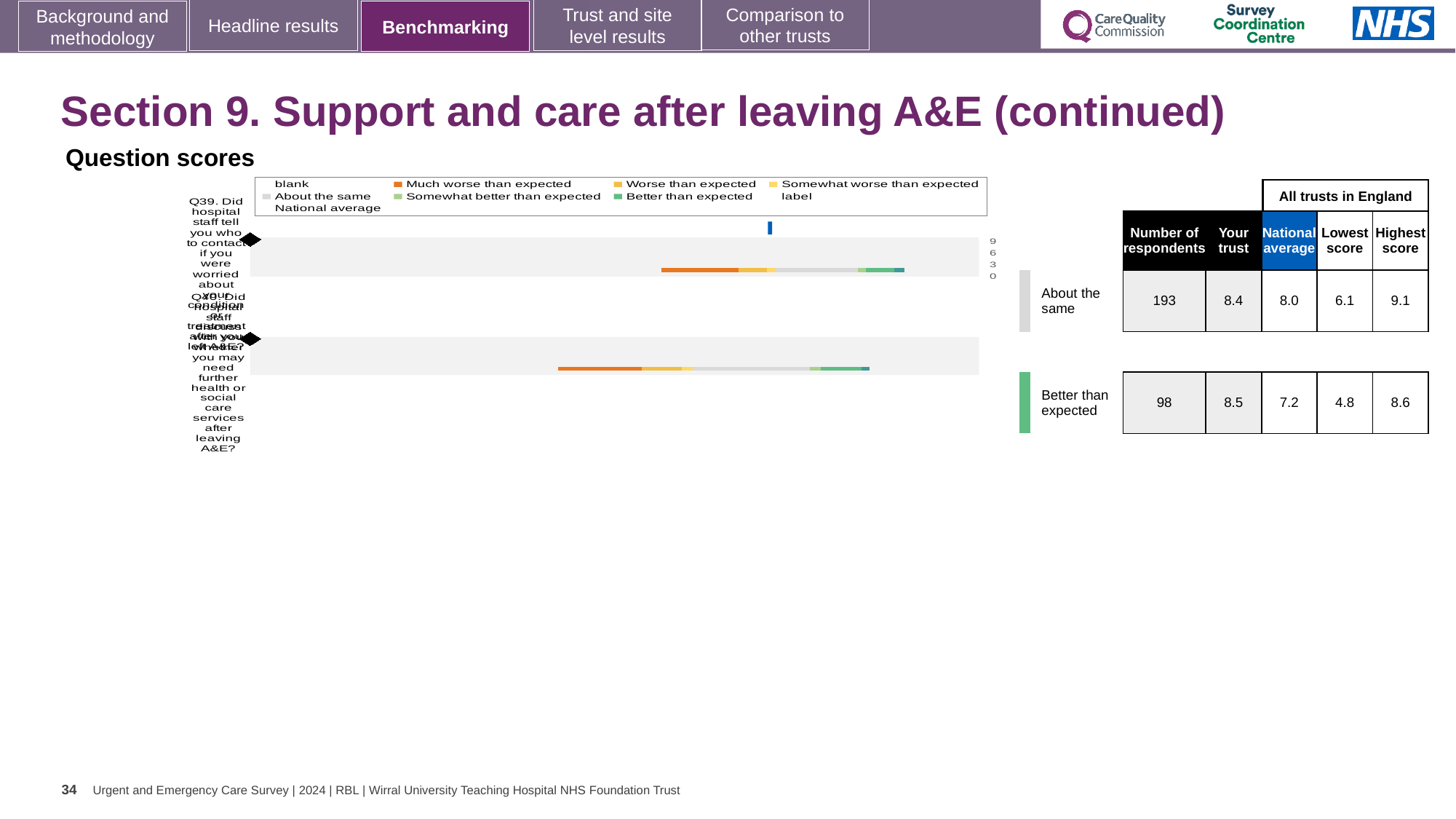
What is the national average score for Q40 (Did hospital staff discuss with you whether you may need further health or social care services after leaving A&E)? 7.2 What is the highest score among all trusts in England for Q39? 9.1 How many respondents answered Q40? 98 What is the 'Your trust' score for Q39 (Did hospital staff tell you who to contact if you were worried about your condition or treatment after you left A&E)? 8.4 What benchmark category is Q39 placed in? About the same Which question has the higher 'Your trust' score, Q39 or Q40? Q40 What benchmark category is Q40 placed in? Better than expected What is the lowest score among all trusts in England for Q40? 4.8 How many survey questions are plotted in the question scores chart? 2 What kind of chart is used to show the question scores on this slide? bar chart How many respondents answered Q39? 193 What is the difference between the trust's score and the national average for Q40? 1.3